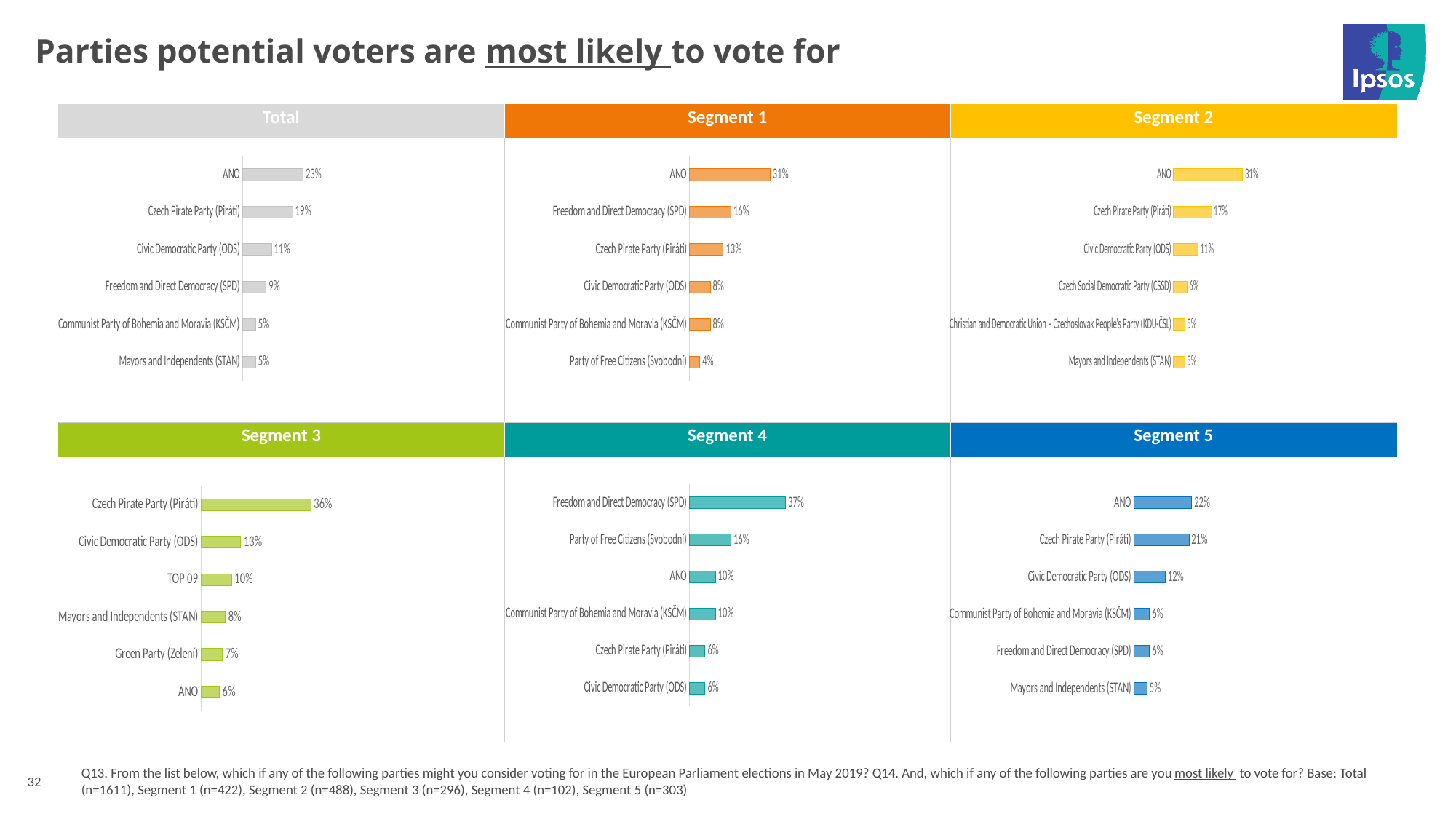
In the Segment 4 chart, which party has the highest value? Freedom and Direct Democracy (SPD) In the Segment 2 chart, what percentage is shown for Czech Social Democratic Party (CSSD)? 6% In the Segment 1 chart, what percentage is shown for Freedom and Direct Democracy (SPD)? 16% In the Segment 2 chart, which party has the highest value? ANO What kind of chart is used in the Segment 5 panel? Bar chart In the Total chart, what percentage is shown for ANO? 23% In the Segment 5 chart, what percentage is shown for Civic Democratic Party (ODS)? 12% In the Segment 3 chart, what is the difference between Czech Pirate Party (Piráti) and Civic Democratic Party (ODS)? 23% In the Total chart, which is larger, Czech Pirate Party (Piráti) or Civic Democratic Party (ODS)? Czech Pirate Party (Piráti) How many segment charts (excluding Total) are shown on the slide? 5 In the Segment 1 chart, which party has the lowest value? Party of Free Citizens (Svobodní) In the Segment 3 chart, how many parties are listed? 6